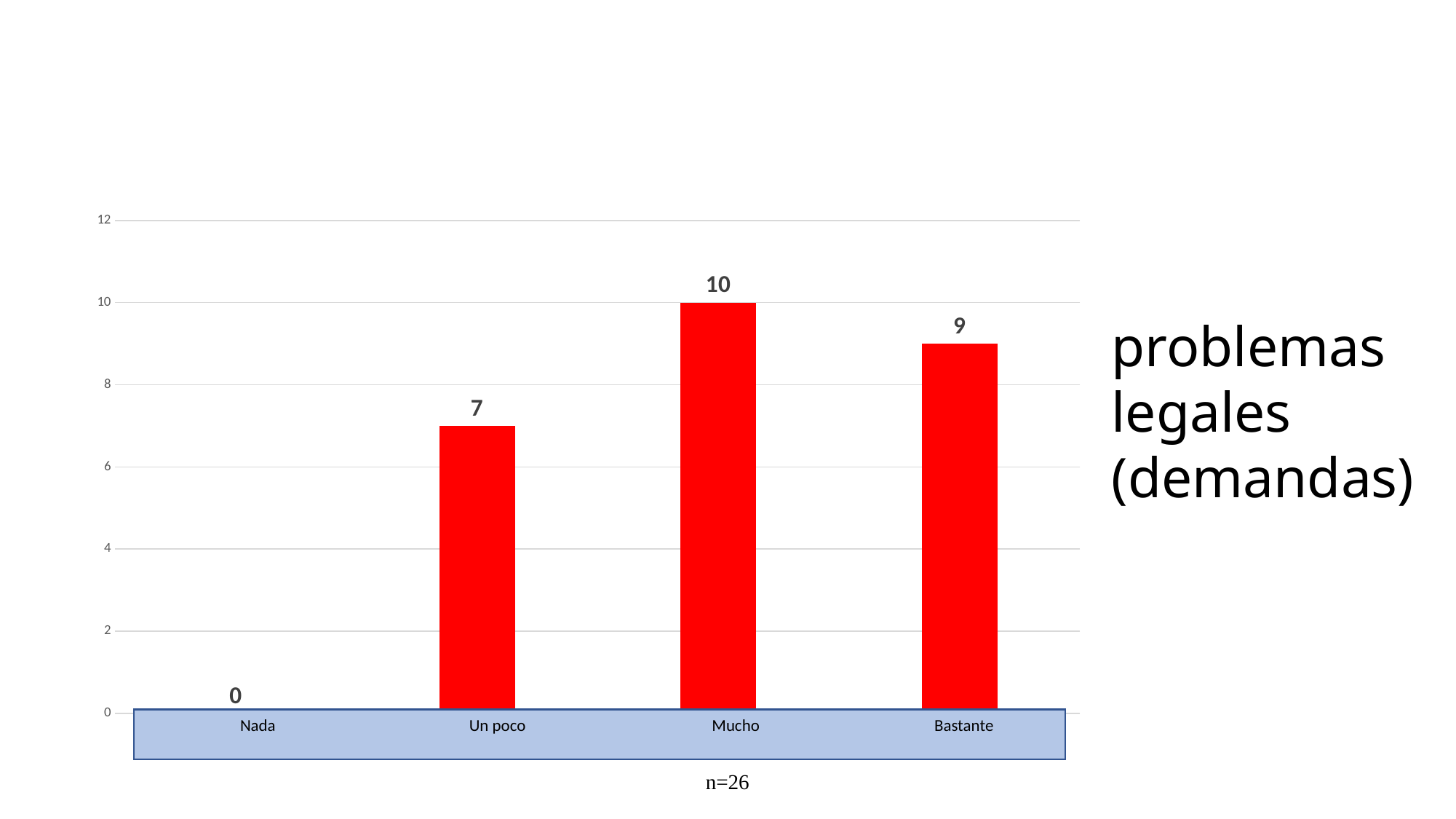
What is the value for Bastante? 9 Is the value for Bastante greater or less than 8? greater Which category has the lowest value? Nada What sample size is noted below the chart? n=26 What is the value for Nada? 0 How many categories are shown on the x axis? 4 What is the value for Mucho? 10 What is the value for Un poco? 7 What is the difference between the values for Mucho and Un poco? 3 What kind of chart is shown on the slide? bar chart Which category has the highest value? Mucho Which is larger, the value for Bastante or the value for Un poco? Bastante